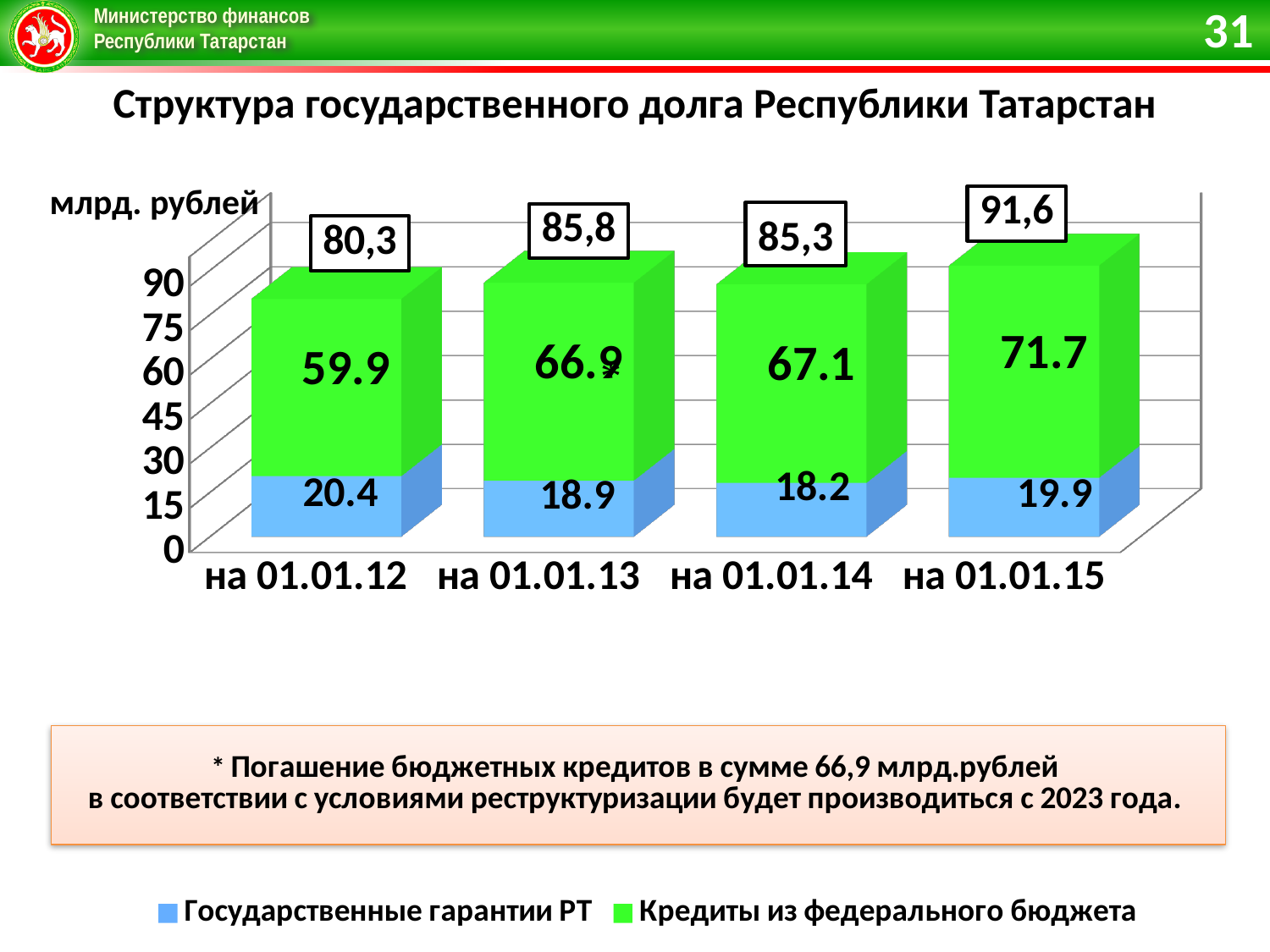
What is the value of Государственные гарантии РТ for на 01.01.14? 18.2 How many series does the legend list? 2 What is the value of Кредиты из федерального бюджета for на 01.01.15? 71.7 What is the difference between Кредиты из федерального бюджета for на 01.01.15 and на 01.01.14? 4.6 What kind of chart is shown on the slide? stacked bar chart Which date has the lowest value for Государственные гарантии РТ? на 01.01.14 Does the value of Кредиты из федерального бюджета rise or fall from на 01.01.12 to на 01.01.15? rise Which date has the highest total government debt? на 01.01.15 What is the value of Кредиты из федерального бюджета for на 01.01.12? 59.9 What is the total of the stacked bar for на 01.01.13 as labelled on the slide? 85,8 Which is larger: Государственные гарантии РТ for на 01.01.12 or for на 01.01.15? на 01.01.12 How many dates (categories) are shown on the x axis? 4